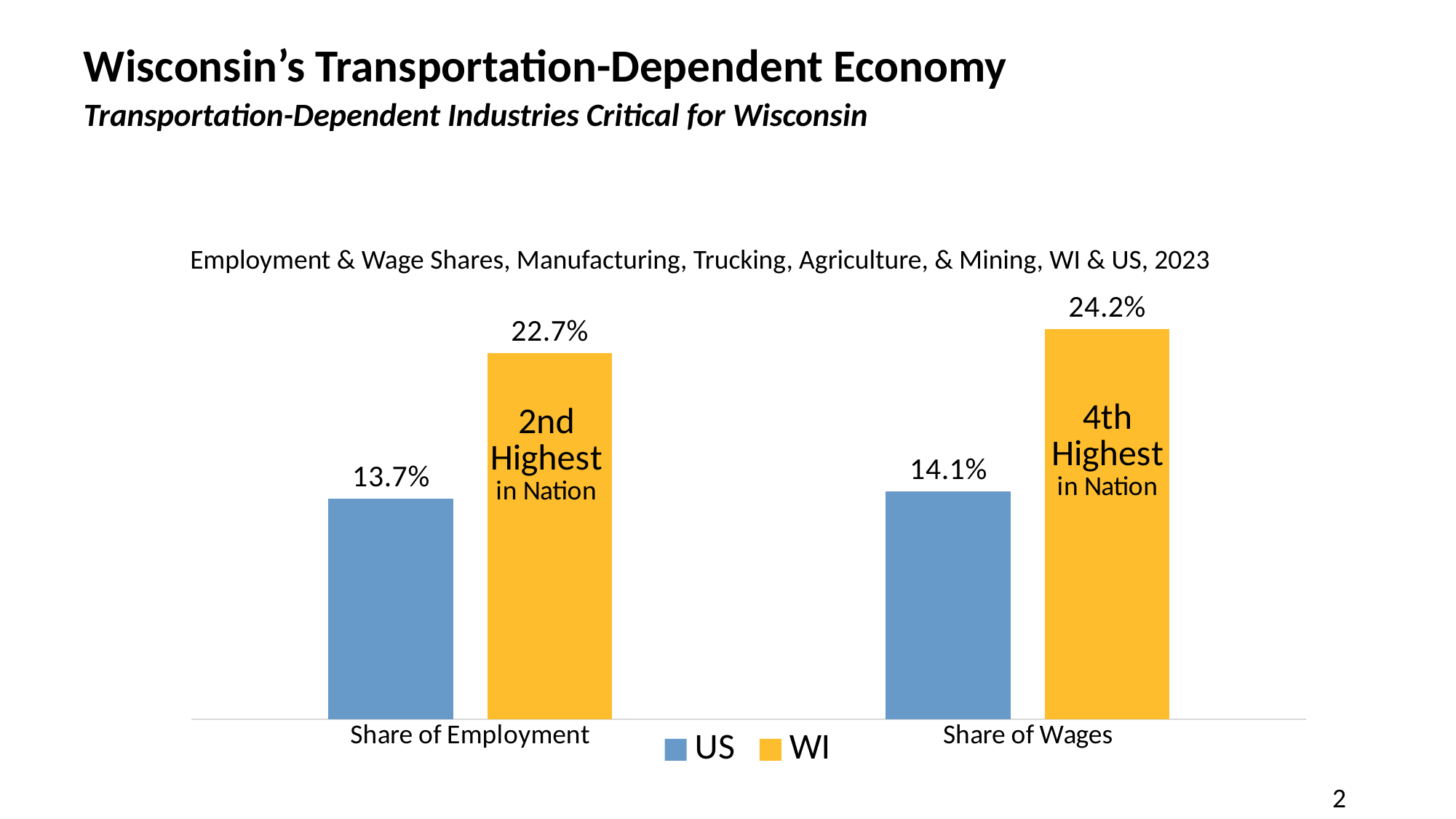
What is the difference between the WI and US values for Share of Employment? 9.0% What is the WI value for Share of Employment? 22.7% Which is larger for Share of Wages, the US value or the WI value? WI How many series does the legend list? 2 What is the US value for Share of Employment? 13.7% What is the WI value for Share of Wages? 24.2% Which bar has the highest value on the chart? WI, Share of Wages What kind of chart is shown on the slide? Bar chart Which bar has the lowest value on the chart? US, Share of Employment What is the US value for Share of Wages? 14.1% How many categories are shown on the x axis? 2 What is the difference between the WI and US values for Share of Wages? 10.1%